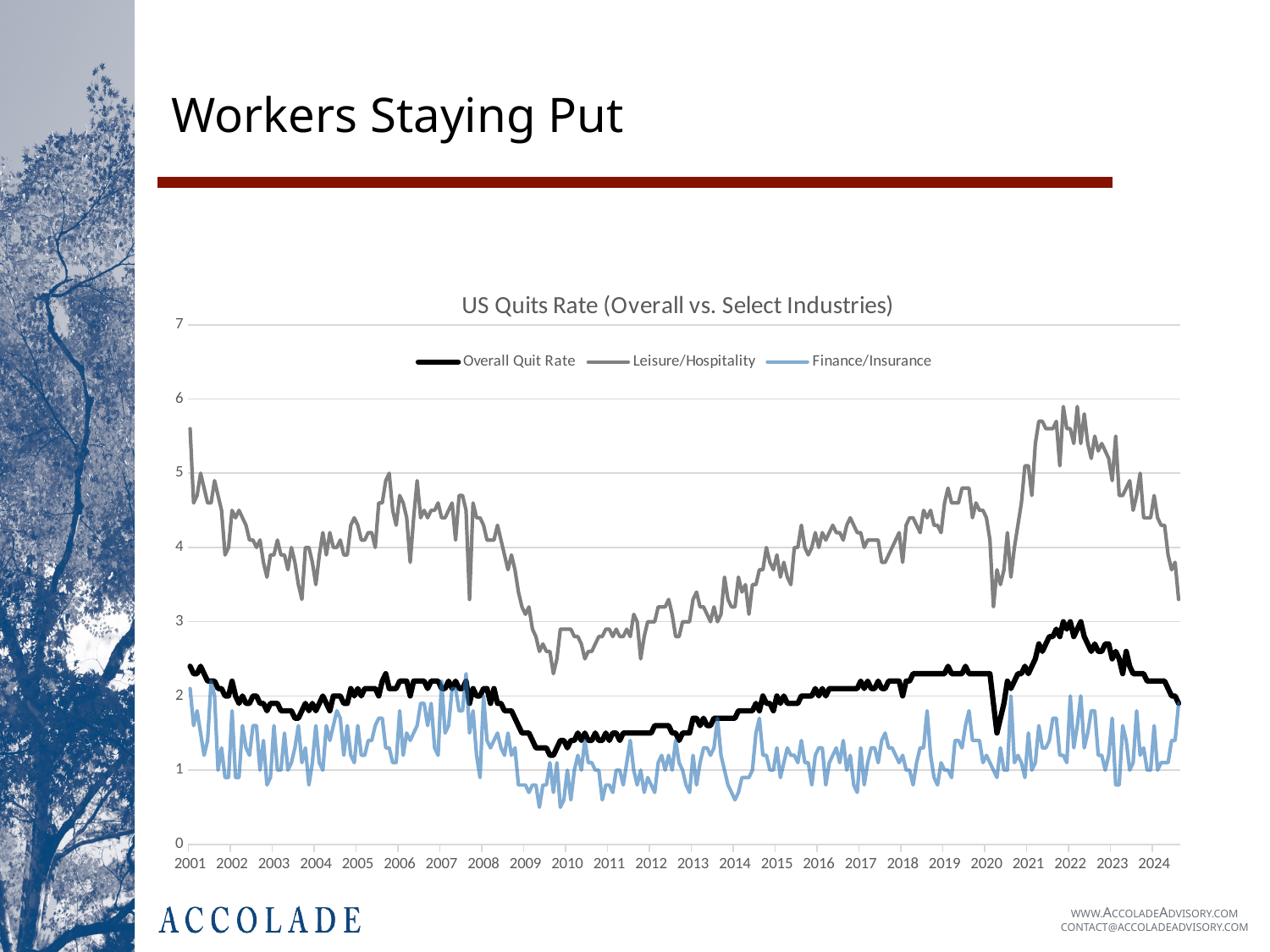
How many years are labeled along the x axis? 24 How many series does the chart legend list? 3 Which series has the lowest values for most of the period shown? Finance/Insurance Is the Leisure/Hospitality value during 2009–2010 greater or less than 3? less What kind of chart is shown on the slide? Line chart Is the peak of the Overall Quit Rate around 2022 greater or less than 2? greater Is the Overall Quit Rate during 2009–2010 greater or less than 2? less What is the title of the chart? US Quits Rate (Overall vs. Select Industries) Does the Leisure/Hospitality series rise or fall from 2022 to 2024? Fall Which series is drawn with the thick black line? Overall Quit Rate Which series is higher throughout the chart, Leisure/Hospitality or Overall Quit Rate? Leisure/Hospitality